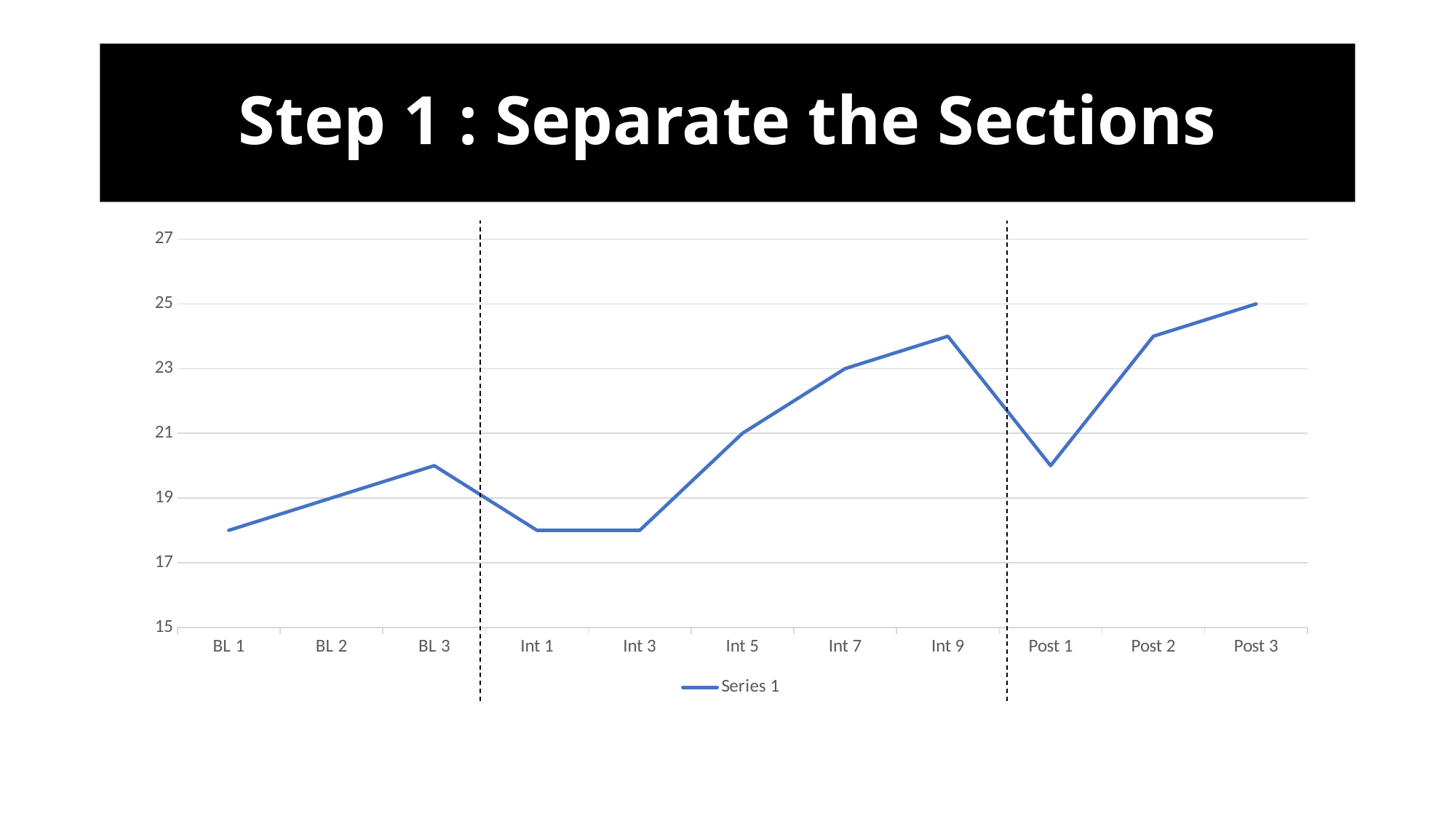
What type of chart is shown on the slide? Line chart How many series does the legend list? 1 What is the title of the slide? Step 1 : Separate the Sections What is the value for Int 7? 23 Is the value for BL 1 greater or less than 19? less Do the values rise or fall from Int 3 to Int 9? rise Which is larger, the value for Int 7 or the value for BL 3? Int 7 What is the difference between the values for Post 3 and Int 5? 4 How many categories are plotted along the x axis? 11 Which category has the highest value? Post 3 What is the value for Int 5? 21 What is the value for Post 3? 25